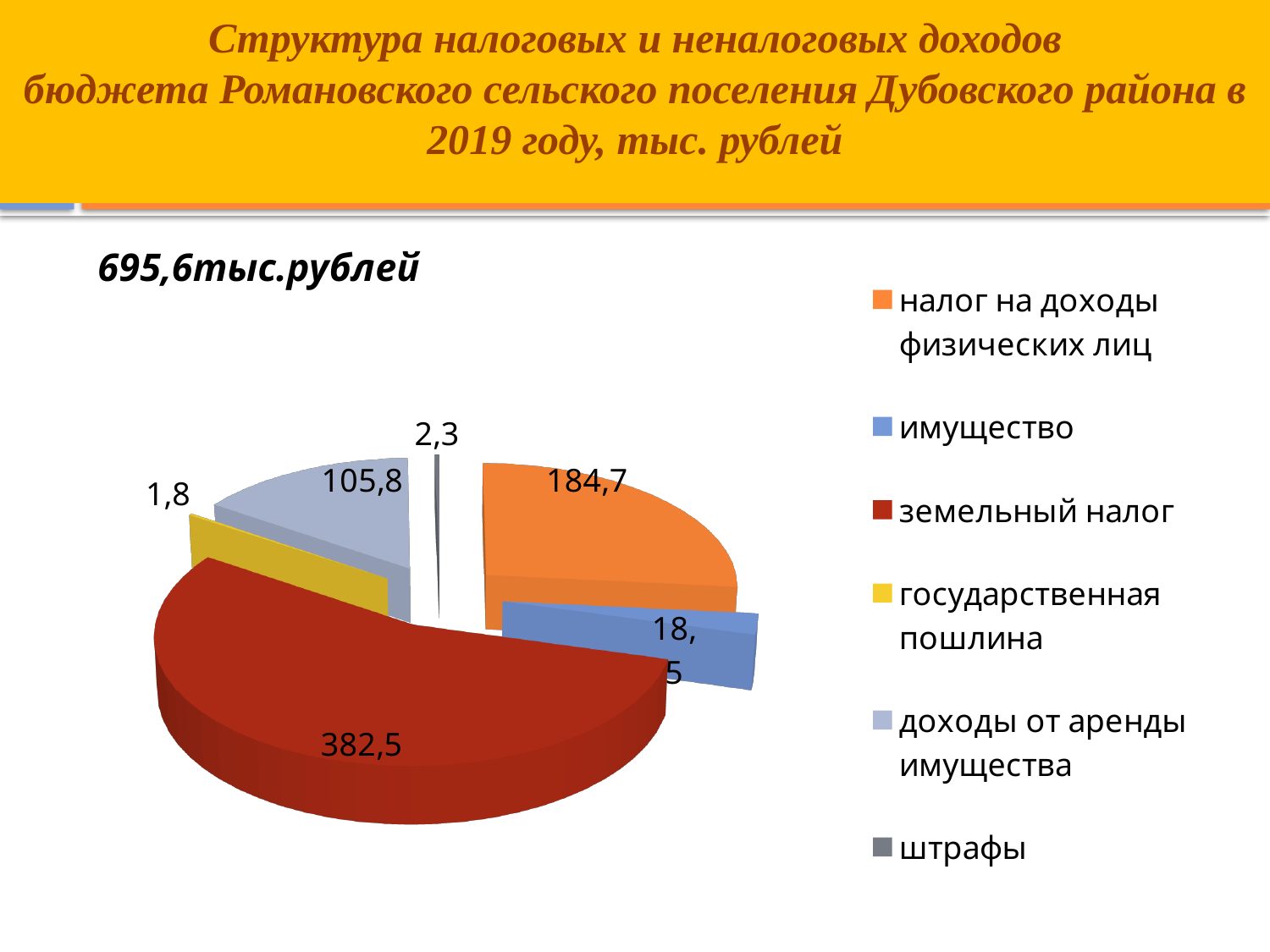
What type of chart is shown on the slide? pie chart What is the value for налог на доходы физических лиц? 184,7 What is the value for штрафы? 2,3 Which category has the smallest slice of the pie? государственная пошлина What is the difference between доходы от аренды имущества and имущество? 87,3 Which is larger, имущество or доходы от аренды имущества? доходы от аренды имущества How many categories does the pie chart show? 6 What is the value for земельный налог in the pie chart? 382,5 What is the value for доходы от аренды имущества? 105,8 Which category has the largest slice of the pie? земельный налог What is the difference between земельный налог and налог на доходы физических лиц? 197,8 What total amount is stated above the pie chart? 695,6тыс.рублей